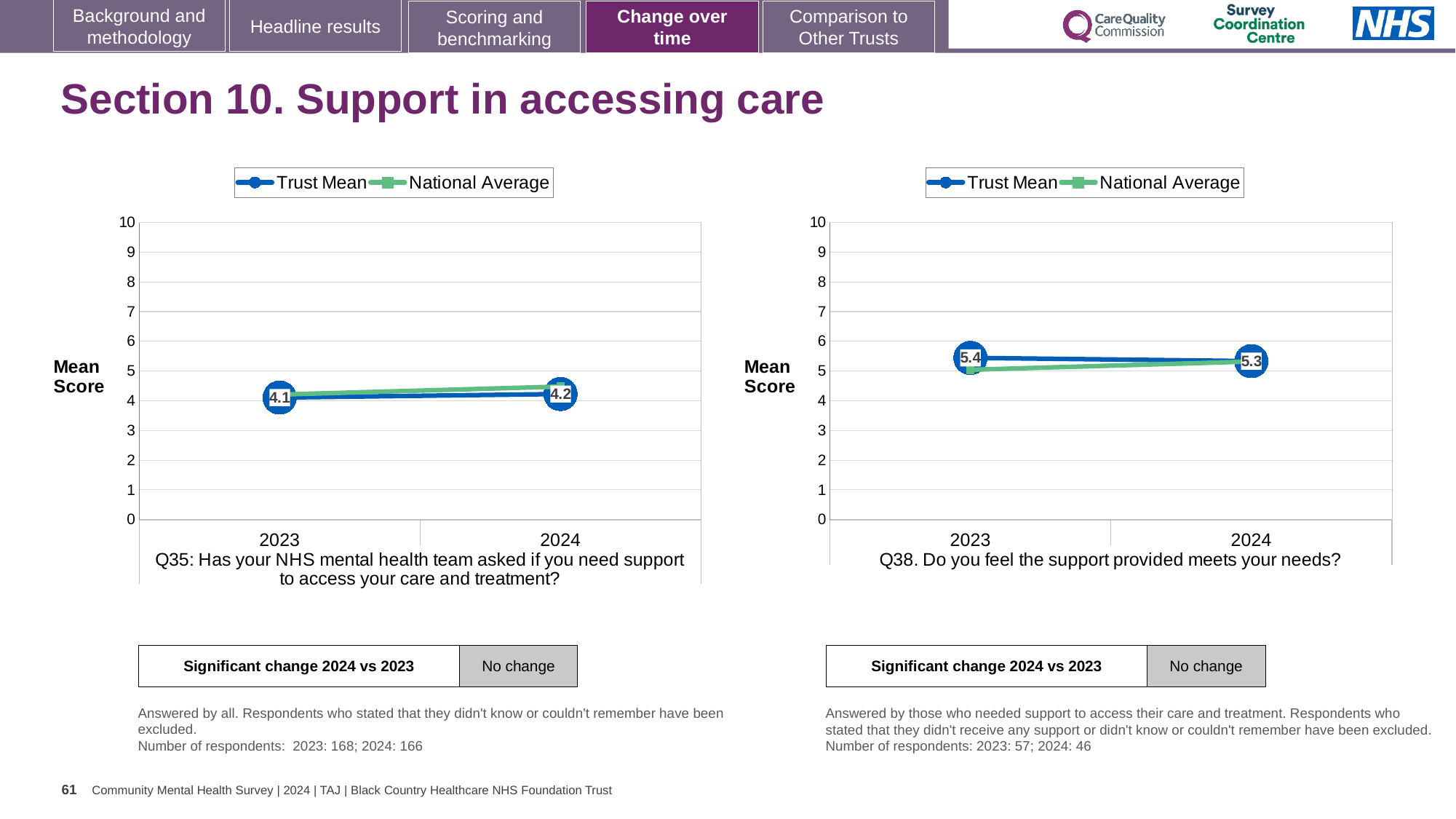
In the Q35 chart on the left, by how much did the Trust Mean change from 2023 to 2024? 0.1 In the Q38 chart on the right, which year has the higher Trust Mean score? 2023 In the Q35 chart on the left, what is the Trust Mean score for 2023? 4.1 In the Q38 chart on the right, does the Trust Mean rise or fall from 2023 to 2024? fall In the Q38 chart on the right, is the National Average value for 2023 greater or less than 4? greater In the Q35 chart on the left, does the Trust Mean rise or fall from 2023 to 2024? rise In the Q38 chart on the right, what is the Trust Mean score for 2024? 5.3 In the Q35 chart on the left, what is the Trust Mean score for 2024? 4.2 How many series does the legend of the Q35 chart on the left list? 2 How many years are shown on the x axis of the Q35 chart on the left? 2 In the Q38 chart on the right, what is the Trust Mean score for 2023? 5.4 What kind of chart is used for Q38 on the right? line chart